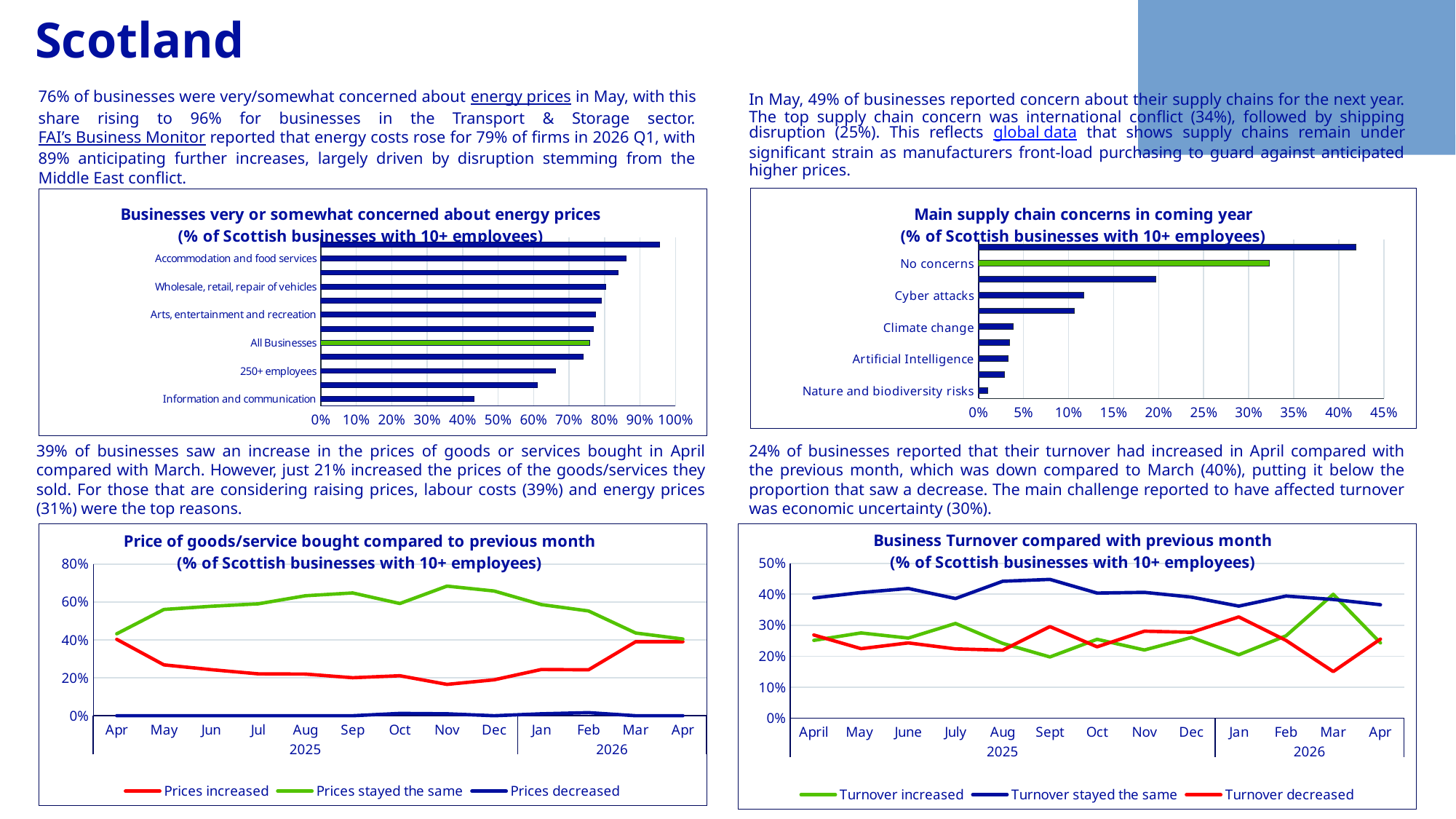
In the 'Price of goods/service bought compared to previous month' chart, which is larger in May 2025: Prices increased or Prices stayed the same? Prices stayed the same In the 'Business Turnover compared with previous month' chart, is the value for Turnover stayed the same in Sept 2025 greater or less than 40%? greater In the 'Businesses very or somewhat concerned about energy prices' chart, is the value for Information and communication greater or less than 50%? less What kind of chart is the 'Price of goods/service bought compared to previous month' chart? line chart In the 'Businesses very or somewhat concerned about energy prices' chart, is the value for All Businesses greater or less than 70%? greater How many series does the legend of the 'Price of goods/service bought compared to previous month' chart list? 3 In the 'Main supply chain concerns in coming year' chart, which is larger: Cyber attacks or Climate change? Cyber attacks What kind of chart is the 'Businesses very or somewhat concerned about energy prices' chart? bar chart How many months are plotted on the x axis of the 'Business Turnover compared with previous month' chart? 13